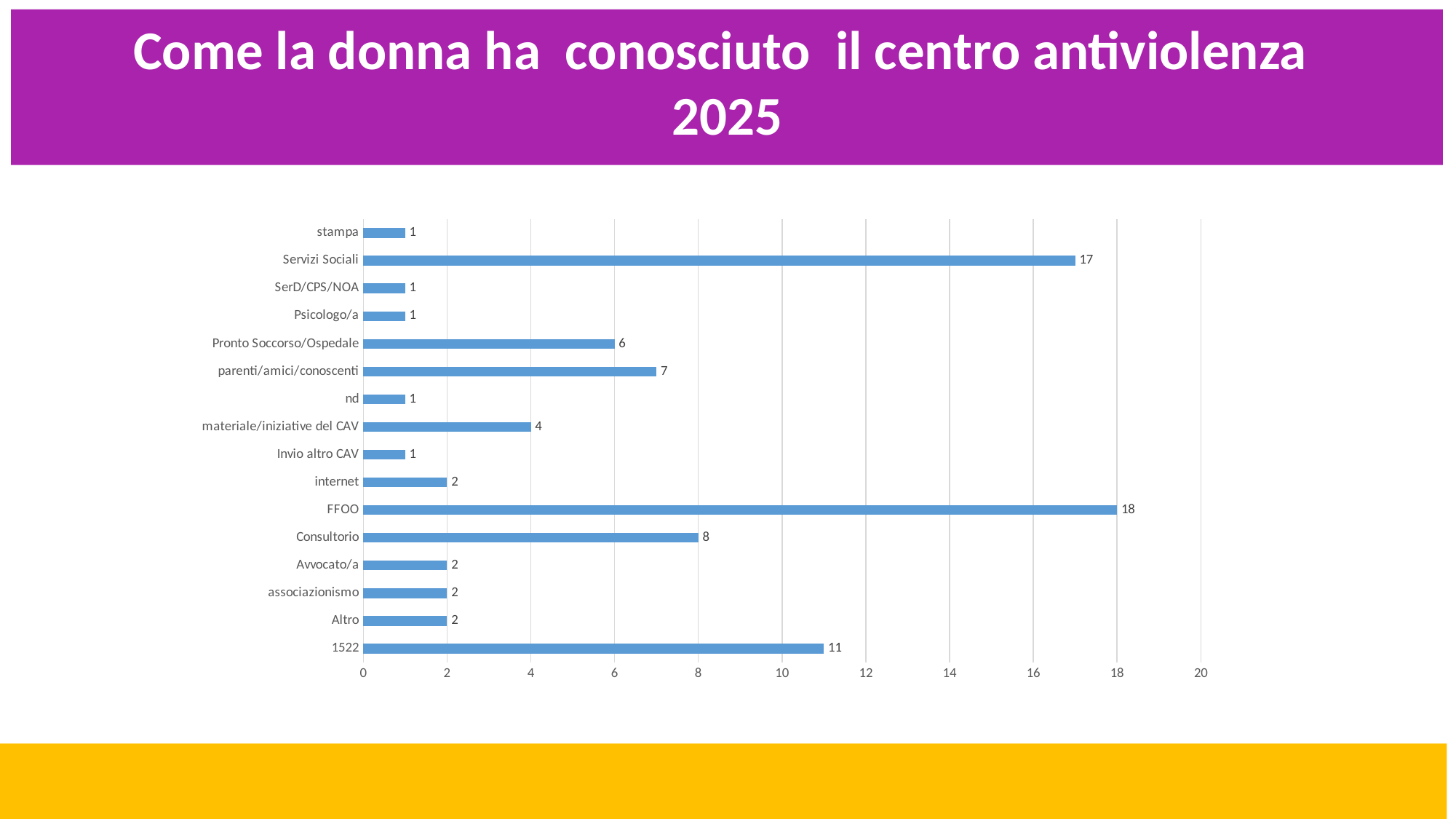
What is the difference between the values for 1522 and Consultorio? 3 What is the title of the slide? Come la donna ha conosciuto il centro antiviolenza 2025 What is the value for 1522? 11 Which is larger, the value for parenti/amici/conoscenti or the value for Pronto Soccorso/Ospedale? parenti/amici/conoscenti What kind of chart is shown on the slide? bar chart What is the difference between the values for FFOO and Servizi Sociali? 1 Is the value for 1522 greater or less than 10? greater What is the value for FFOO? 18 How many categories are shown in the chart? 16 What is the value for Servizi Sociali? 17 Which category has the highest value? FFOO What is the value for Consultorio? 8